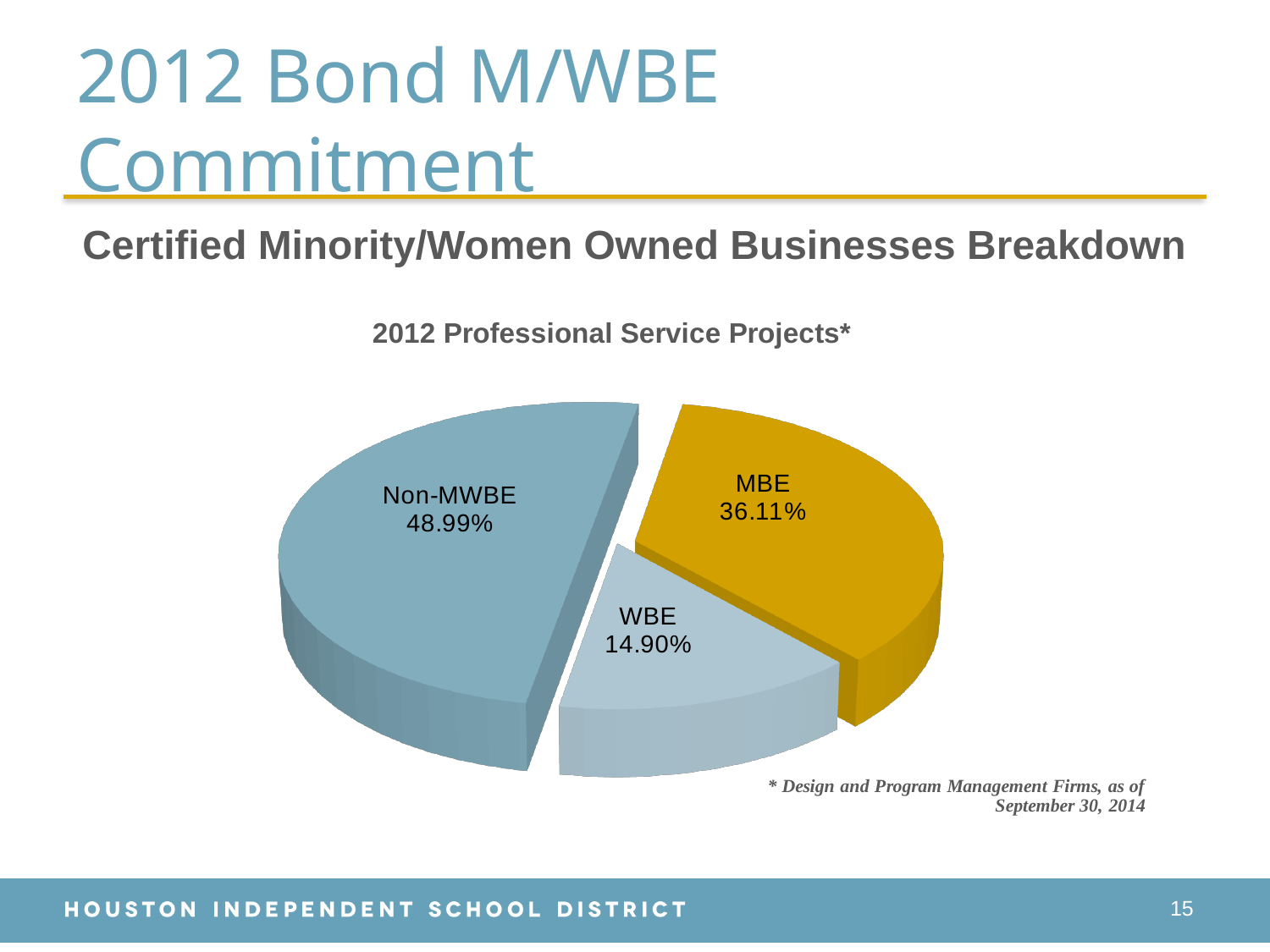
How many slices does the pie chart have? 3 What share of the pie does WBE represent? 14.90% What is the title of the chart? 2012 Professional Service Projects* What share of the pie does MBE represent? 36.11% Which slice of the pie is the largest? Non-MWBE What is the combined share of the MBE and WBE slices? 51.01% What share of the pie does Non-MWBE represent? 48.99% What is the difference in percentage points between the MBE and WBE slices? 21.21 Which slice of the pie is the smallest? WBE What kind of chart is shown on the slide? Pie chart What is the difference in percentage points between the Non-MWBE and MBE slices? 12.88 Which is larger, the MBE slice or the WBE slice? MBE